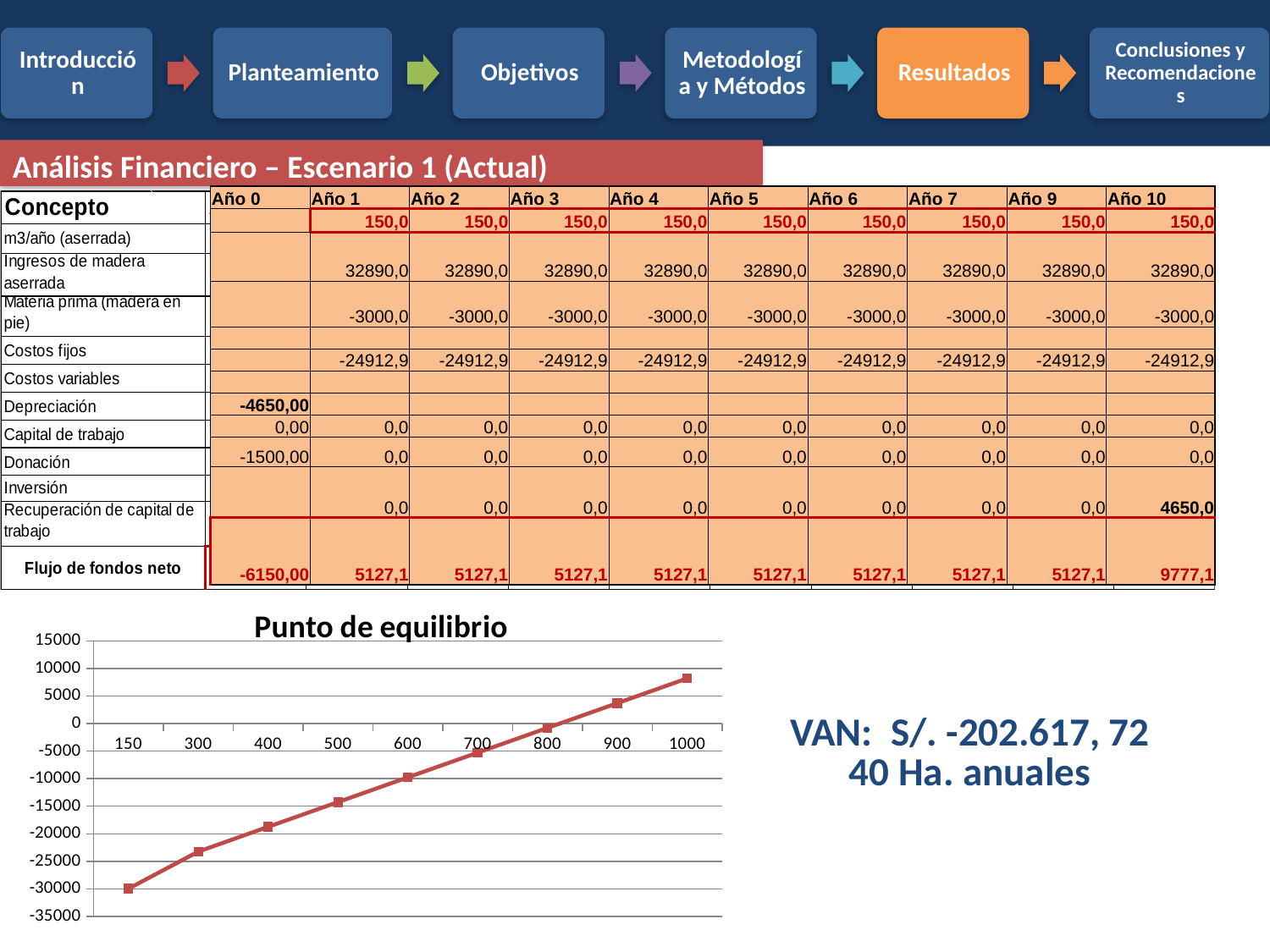
Which x-axis category has the highest value on the "Punto de equilibrio" chart? 1000 On the "Punto de equilibrio" chart, is the value for 700 greater or less than 0? less Which x-axis category has the lowest value on the "Punto de equilibrio" chart? 150 On the "Punto de equilibrio" chart, is the value for 1000 greater or less than 5000? greater On the "Punto de equilibrio" chart, which has the larger value, 300 or 900? 900 How many data points are plotted on the "Punto de equilibrio" chart? 9 Do the values on the "Punto de equilibrio" chart rise or fall as the x-axis values increase? rise On the "Punto de equilibrio" chart, is the value for 500 greater or less than -10000? less What type of chart is the "Punto de equilibrio" chart? line chart What is the title of the chart on the slide? Punto de equilibrio